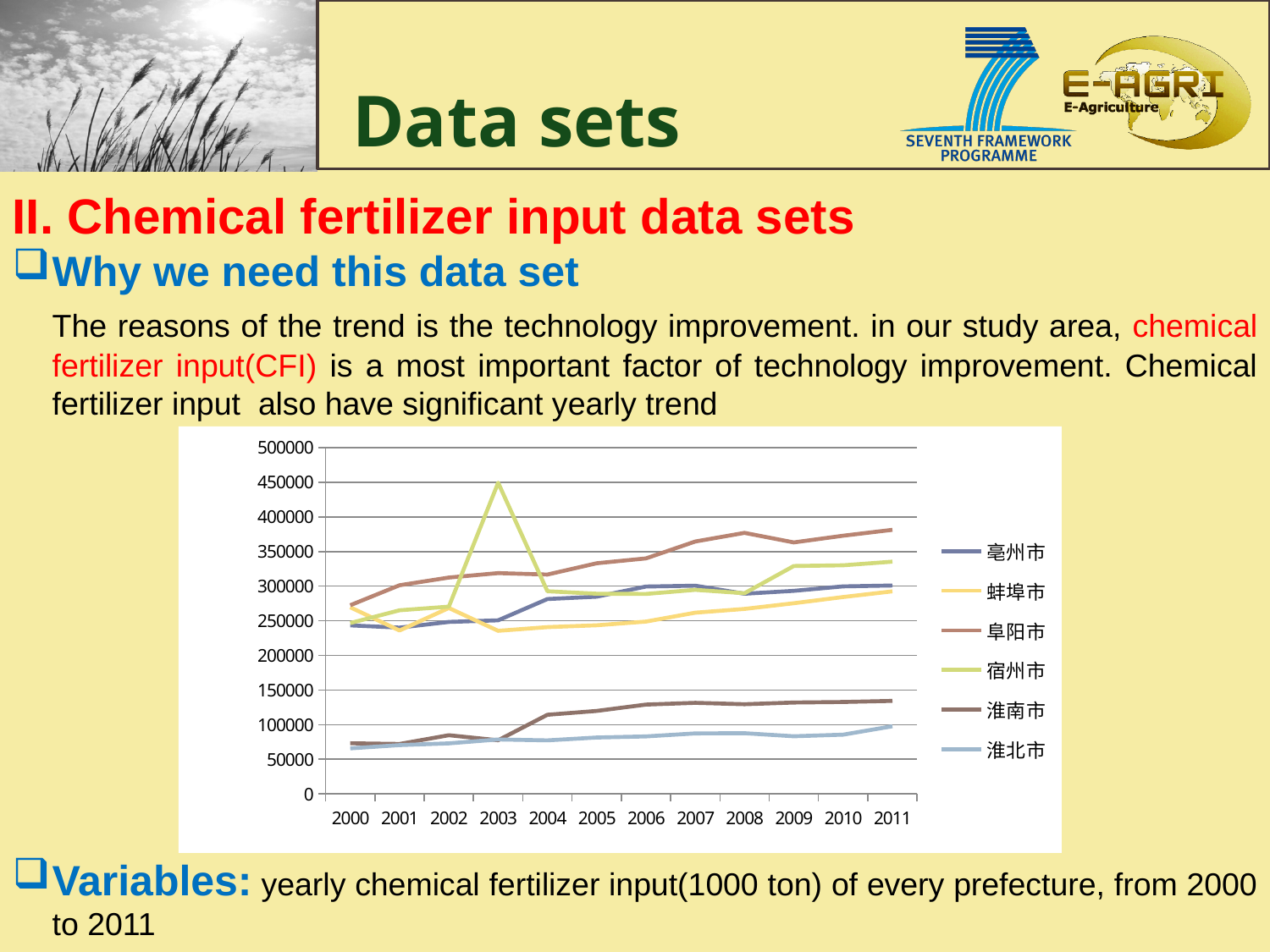
How many years are shown along the x axis of the chart? 12 Is the value for 阜阳市 in 2011 greater or less than 350000? greater How many series does the legend of the chart list? 6 Which series has the highest value in 2003? 宿州市 What kind of chart is shown on the slide? Line chart Which series has the highest value in 2011? 阜阳市 Is the value for 宿州市 in 2003 greater or less than 400000? greater In 2008, which is larger: the value for 淮南市 or the value for 淮北市? 淮南市 Does the value for 阜阳市 generally rise or fall from 2000 to 2011? rise Is the value for 淮北市 in 2000 greater or less than 100000? less Which series has the lowest value in 2011? 淮北市 What is the first entry listed in the chart's legend? 亳州市